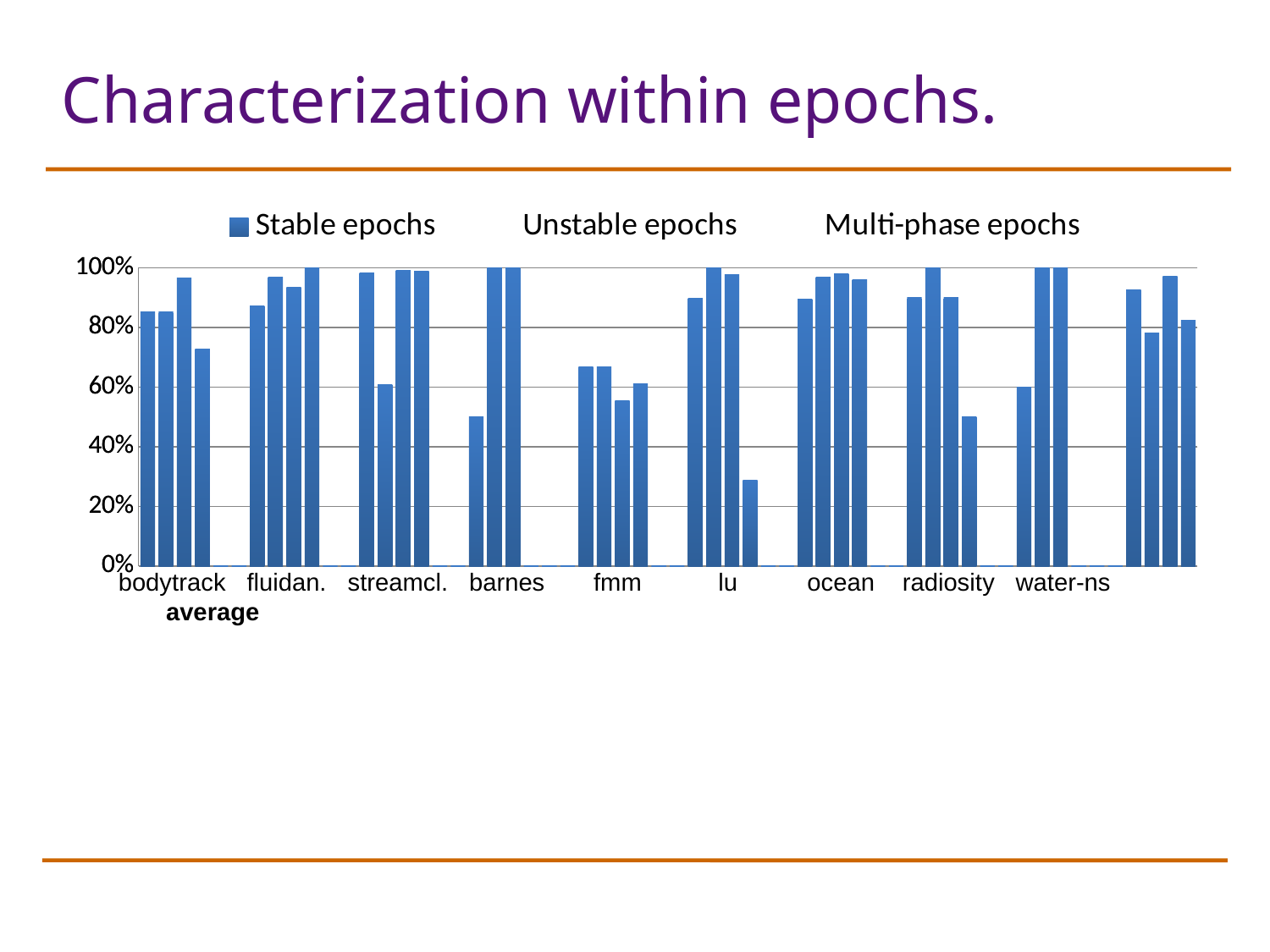
How many benchmark groups (including average) are labelled along the x axis of the chart? 10 Is the value of the shortest bar in the bodytrack group greater or less than 80%? less Is the value of the shortest bar in the bodytrack group greater or less than 60%? greater Is the value of the shortest bar in the lu group greater or less than 40%? less How many series does the chart legend list? 3 Which is larger: the shortest bar in the lu group or the shortest bar in the fmm group? the shortest bar in the fmm group What kind of chart is shown on the slide? bar chart What is the title of the slide containing the chart? Characterization within epochs. What are the three series names listed in the chart legend? Stable epochs, Unstable epochs, Multi-phase epochs